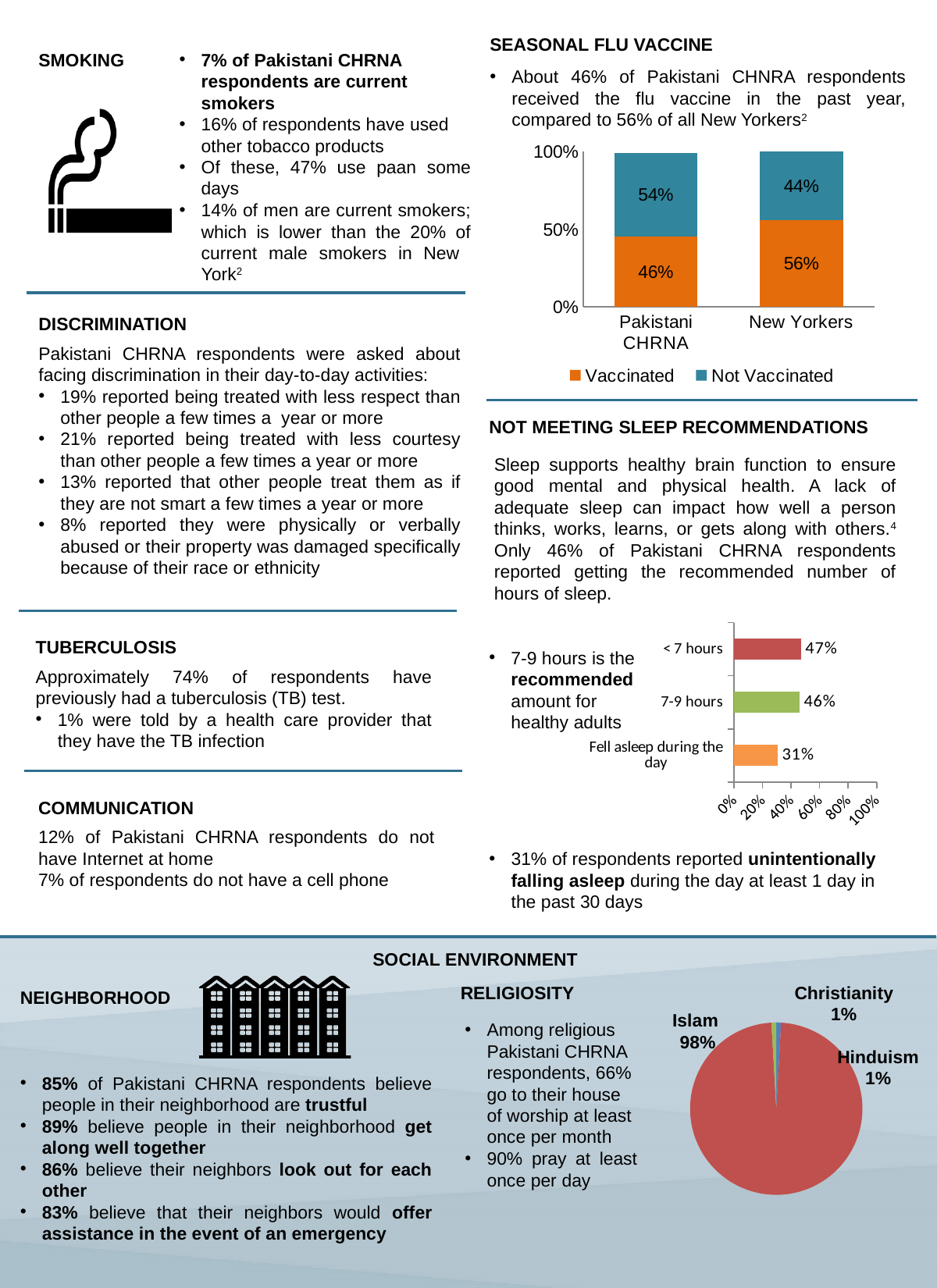
In the sleep chart under Not Meeting Sleep Recommendations, how many categories are plotted? 3 In the Seasonal Flu Vaccine chart, what percentage of Pakistani CHRNA respondents were vaccinated? 46% In the Seasonal Flu Vaccine chart, what is the total of the stacked bar for Pakistani CHRNA? 100% In the Seasonal Flu Vaccine chart, which group has the larger vaccinated share, Pakistani CHRNA or New Yorkers? New Yorkers In the Seasonal Flu Vaccine chart, what is the difference between the vaccinated share for New Yorkers and for Pakistani CHRNA? 10% In the sleep chart under Not Meeting Sleep Recommendations, what is the value for '< 7 hours'? 47% In the sleep chart under Not Meeting Sleep Recommendations, which category has the lowest value? Fell asleep during the day In the Religiosity pie chart, what share is Islam? 98% In the Seasonal Flu Vaccine chart, what percentage of New Yorkers were not vaccinated? 44% In the Religiosity pie chart, what share is Hinduism? 1% What kind of chart is the sleep chart under Not Meeting Sleep Recommendations? Bar chart In the Seasonal Flu Vaccine chart, how many series does the legend list? 2